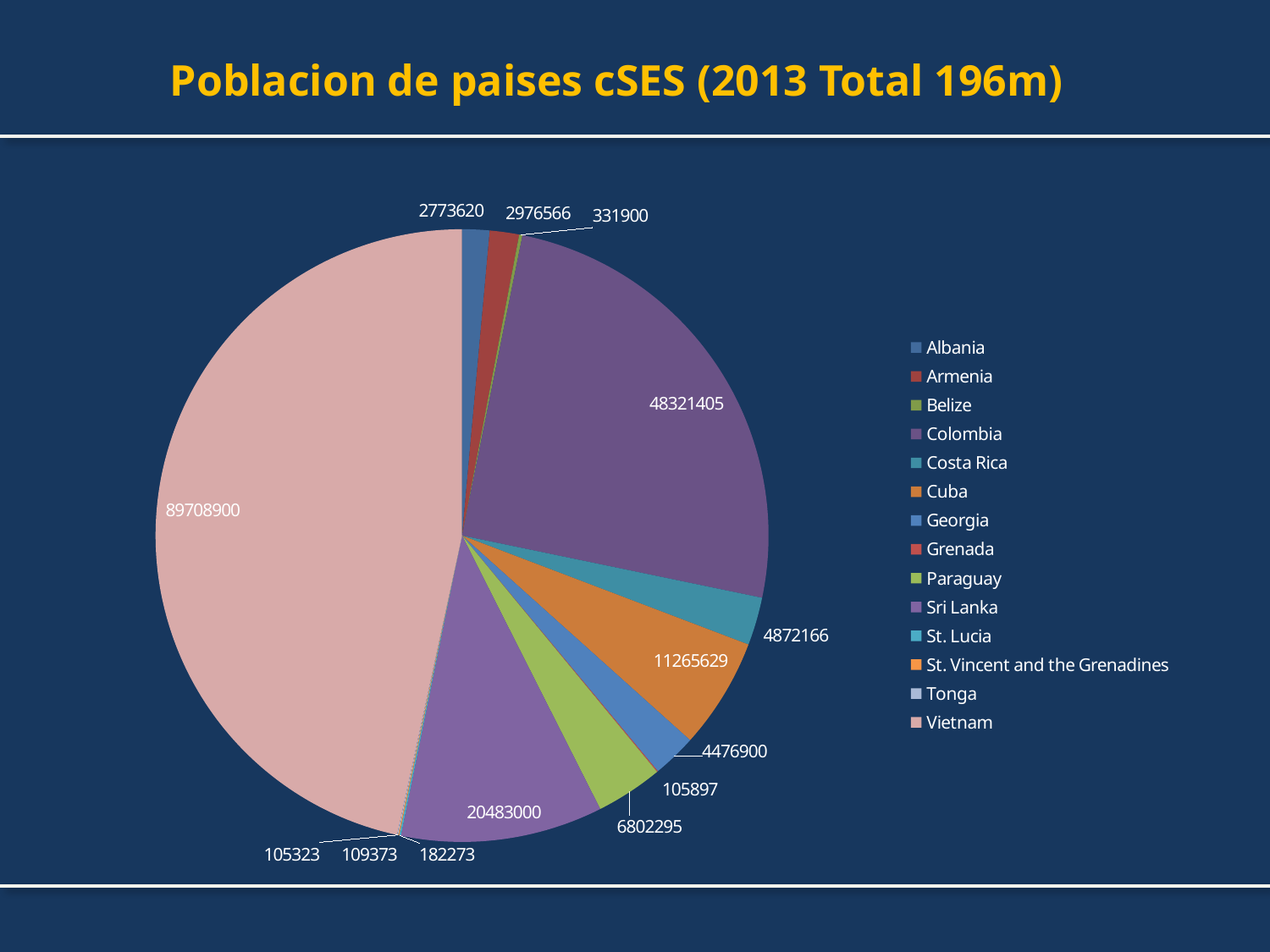
What is the population value shown for Sri Lanka? 20483000 What is the title of the chart? Poblacion de paises cSES (2013 Total 196m) What is the difference between the values for Colombia and Sri Lanka? 27838405 What is the population value shown for Vietnam? 89708900 What kind of chart is shown on the slide? pie chart Which country has the largest slice of the pie? Vietnam Which has the larger value, Costa Rica or Georgia? Costa Rica What is the population value shown for Cuba? 11265629 What is the population value shown for Colombia? 48321405 How many countries does the legend list? 14 Which country has the smallest value shown on the chart? Tonga What is the population value shown for Paraguay? 6802295